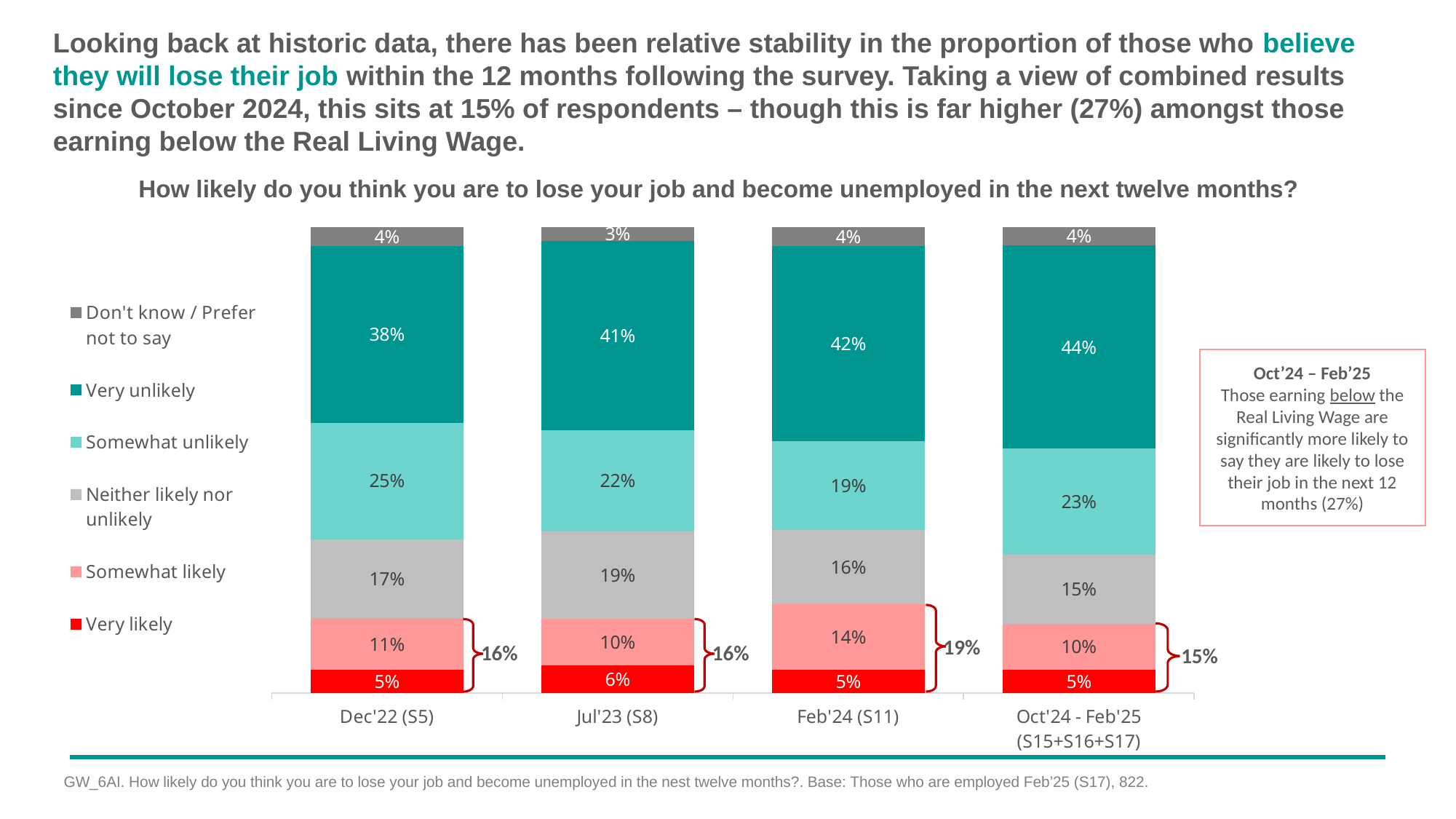
What type of chart is shown on the slide? Stacked bar chart What percentage of respondents said 'Neither likely nor unlikely' in Dec'22 (S5)? 17% How many response categories does the legend list? 6 What is the combined 'Very likely' and 'Somewhat likely' percentage shown by the bracket for Feb'24 (S11)? 19% What percentage of respondents said 'Somewhat likely' in Feb'24 (S11)? 14% Which survey wave has the lowest 'Somewhat unlikely' percentage? Feb'24 (S11) How many survey waves (bars) are shown in the chart? 4 What is the difference between the 'Somewhat unlikely' percentage in Dec'22 (S5) and in Feb'24 (S11)? 6 percentage points Which survey wave has the highest 'Very unlikely' percentage? Oct'24 - Feb'25 (S15+S16+S17) Which is larger: the 'Neither likely nor unlikely' percentage in Jul'23 (S8) or in Oct'24 - Feb'25 (S15+S16+S17)? Jul'23 (S8) What percentage of respondents said 'Very unlikely' in the Oct'24 - Feb'25 (S15+S16+S17) bar? 44% What percentage of respondents said 'Very likely' in Jul'23 (S8)? 6%